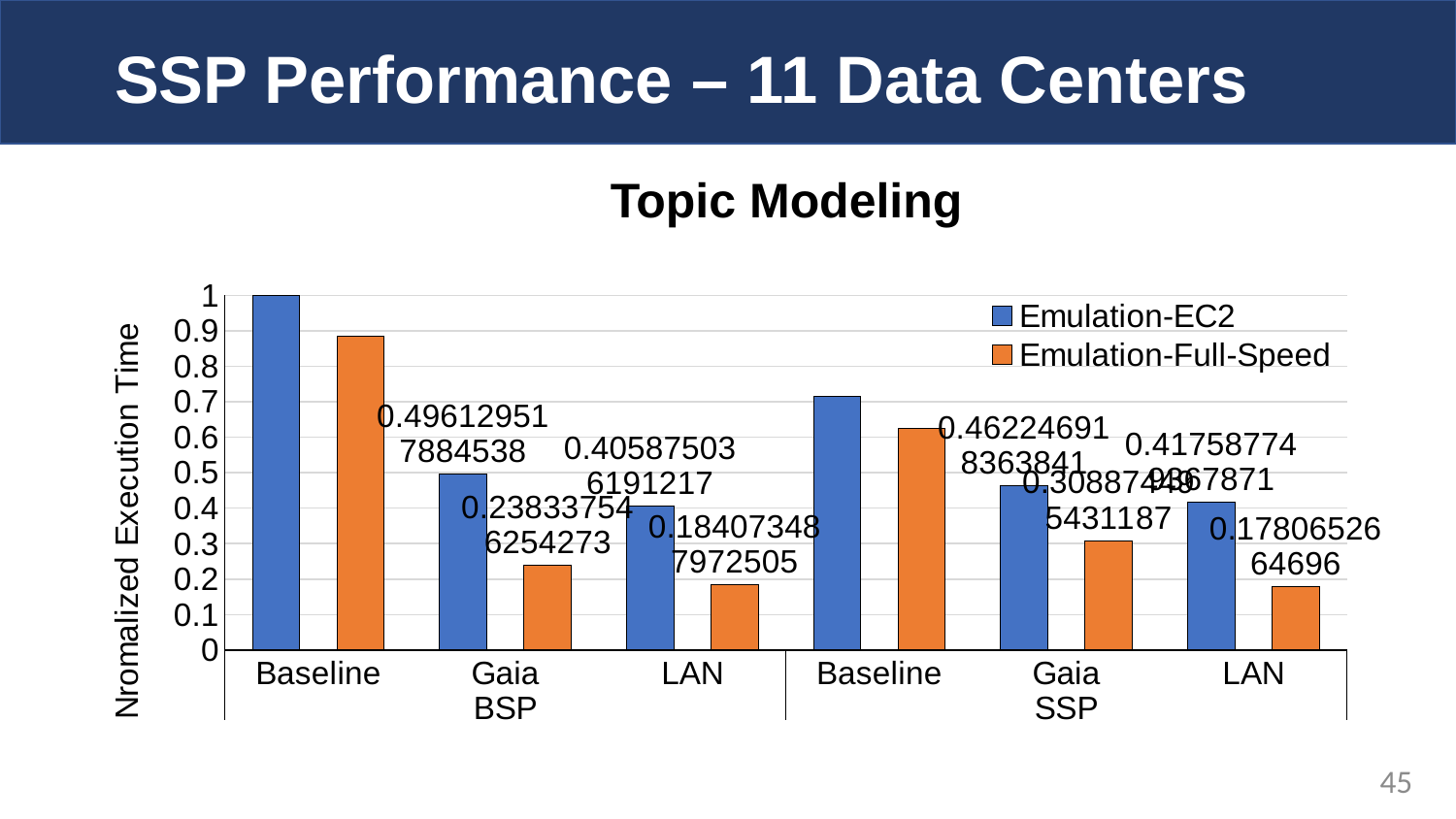
What kind of chart is shown on the slide? bar chart Which category has the highest Emulation-EC2 value? Baseline (BSP) What is the difference between the Emulation-EC2 and Emulation-Full-Speed values for LAN under BSP? 0.221801548218712 Which is larger: the Emulation-EC2 value for Gaia under BSP or for Gaia under SSP? Gaia under BSP Which bar has the lowest value in the chart? Emulation-Full-Speed for LAN under SSP What is the Emulation-Full-Speed value for LAN under BSP? 0.184073487972505 What is the Emulation-EC2 value for LAN under SSP? 0.417587749867871 What is the Emulation-EC2 value for Gaia under BSP? 0.496129517884538 How many series does the legend list? 2 Is the Emulation-Full-Speed value for Baseline under BSP greater or less than 0.8? greater How many categories are shown along the x axis? 6 What is the Emulation-Full-Speed value for LAN under SSP? 0.1780652664696